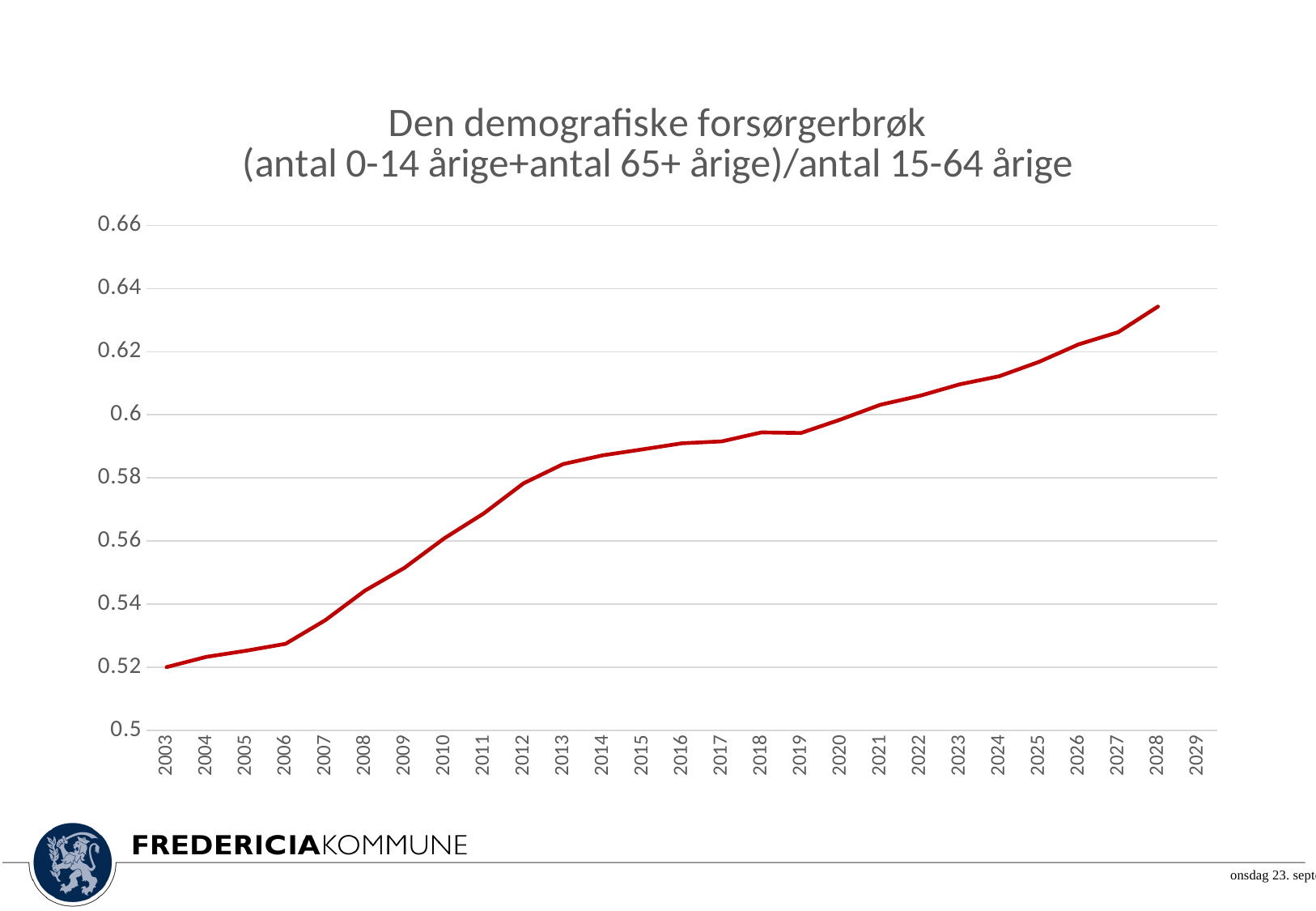
Is the value for 2024 greater or less than 0.6? greater What is the first year shown on the x axis? 2003 What kind of chart is shown on the slide? line chart Do the values rise or fall from 2003 to 2028? rise Is the value for 2028 greater or less than 0.62? greater Is the value for 2003 greater or less than 0.54? less Which year has the lowest value on the chart? 2003 Which year has the larger value, 2010 or 2020? 2020 Which year has the highest value on the chart? 2028